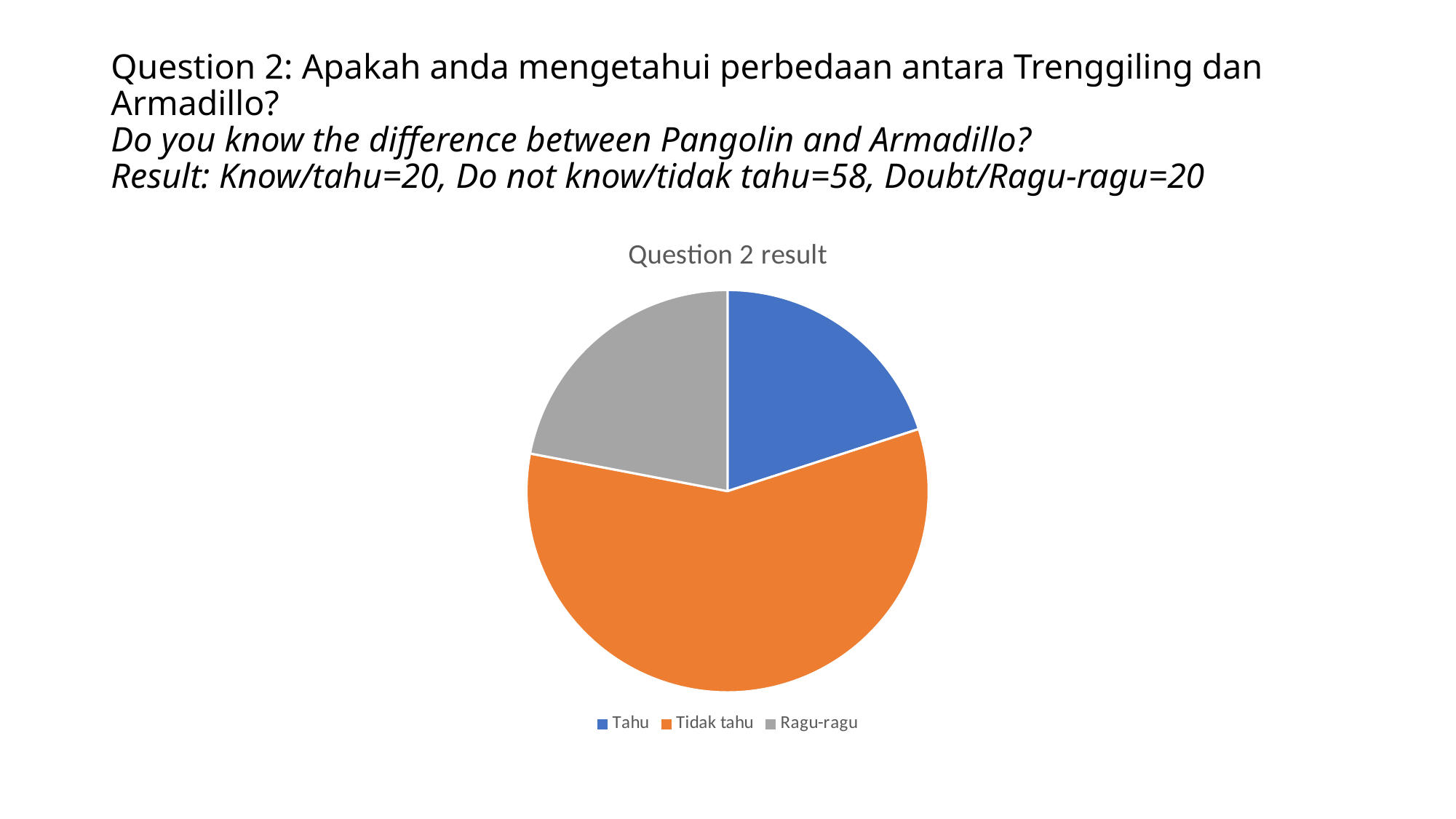
What is the title of the chart? Question 2 result What type of chart is shown on the slide? pie chart Which category has the largest slice of the pie? Tidak tahu How many slices does the pie chart have? 3 What is the value for Tahu? 20 What is the value for Tidak tahu? 58 Which is larger, the slice for Tidak tahu or the slice for Tahu? Tidak tahu How many entries does the chart legend list? 3 Which colour represents Tidak tahu in the pie chart? orange